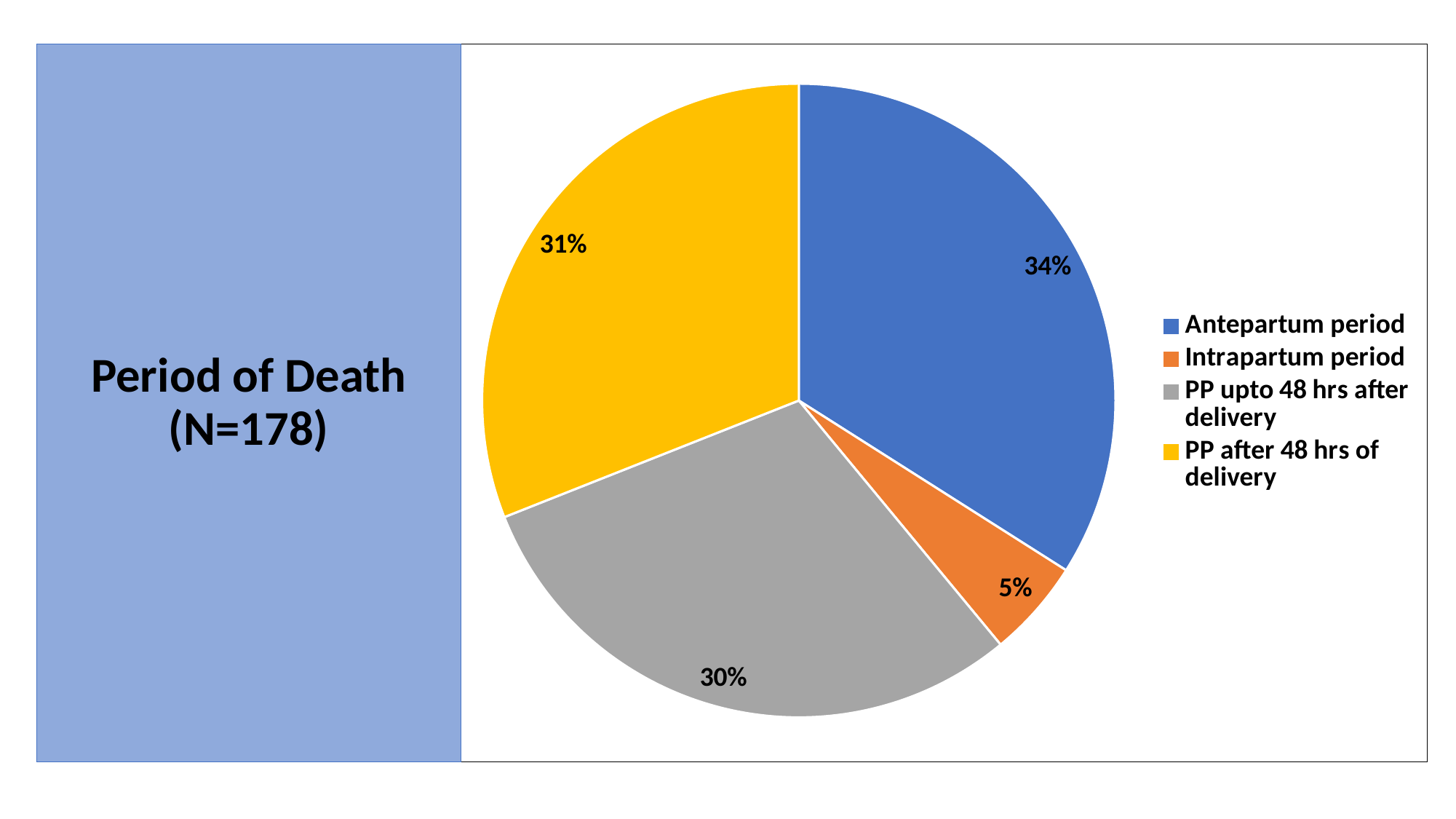
What percentage of deaths occurred in the Intrapartum period? 5% How many categories does the pie chart show? 4 What percentage of deaths occurred PP after 48 hrs of delivery? 31% What is the difference in percentage points between the Antepartum period and the Intrapartum period? 29 What percentage of deaths occurred PP upto 48 hrs after delivery? 30% What percentage of deaths occurred in the Antepartum period? 34% What is the title shown next to the chart? Period of Death (N=178) What kind of chart is shown on the slide? Pie chart Which is larger: the share for PP upto 48 hrs after delivery or the share for Intrapartum period? PP upto 48 hrs after delivery Which colour represents the Intrapartum period in the pie chart? Orange Which period of death has the smallest share of the pie? Intrapartum period Which period of death has the largest share of the pie? Antepartum period